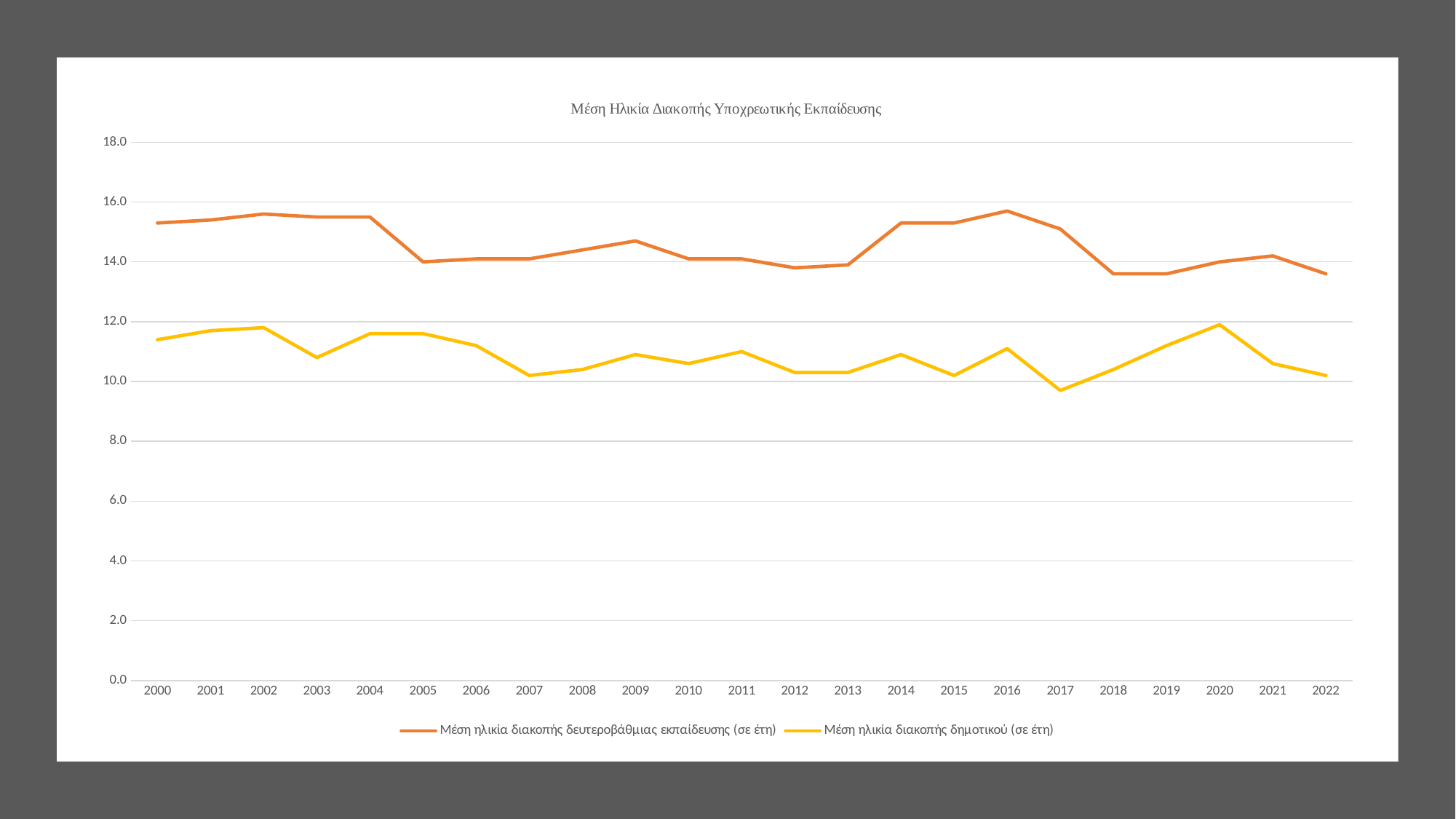
How many years are shown along the x axis? 23 Which colour is used for the series 'Μέση ηλικία διακοπής δημοτικού (σε έτη)'? yellow What is the title of the chart? Μέση Ηλικία Διακοπής Υποχρεωτικής Εκπαίδευσης In which year is the value for 'Μέση ηλικία διακοπής δημοτικού (σε έτη)' lowest? 2017 For 'Μέση ηλικία διακοπής δημοτικού (σε έτη)', which year has the larger value, 2002 or 2007? 2002 Which series has the higher value in 2010, 'Μέση ηλικία διακοπής δευτεροβάθμιας εκπαίδευσης (σε έτη)' or 'Μέση ηλικία διακοπής δημοτικού (σε έτη)'? Μέση ηλικία διακοπής δευτεροβάθμιας εκπαίδευσης (σε έτη) How many series does the legend list? 2 Is the value for 'Μέση ηλικία διακοπής δευτεροβάθμιας εκπαίδευσης (σε έτη)' in 2018 greater or less than 14.0? less Does the value for 'Μέση ηλικία διακοπής δημοτικού (σε έτη)' rise or fall from 2017 to 2020? rise Is the value for 'Μέση ηλικία διακοπής δημοτικού (σε έτη)' in 2002 greater or less than 10.0? greater Is the value for 'Μέση ηλικία διακοπής δευτεροβάθμιας εκπαίδευσης (σε έτη)' in 2016 greater or less than 14.0? greater What kind of chart is shown on the slide? line chart